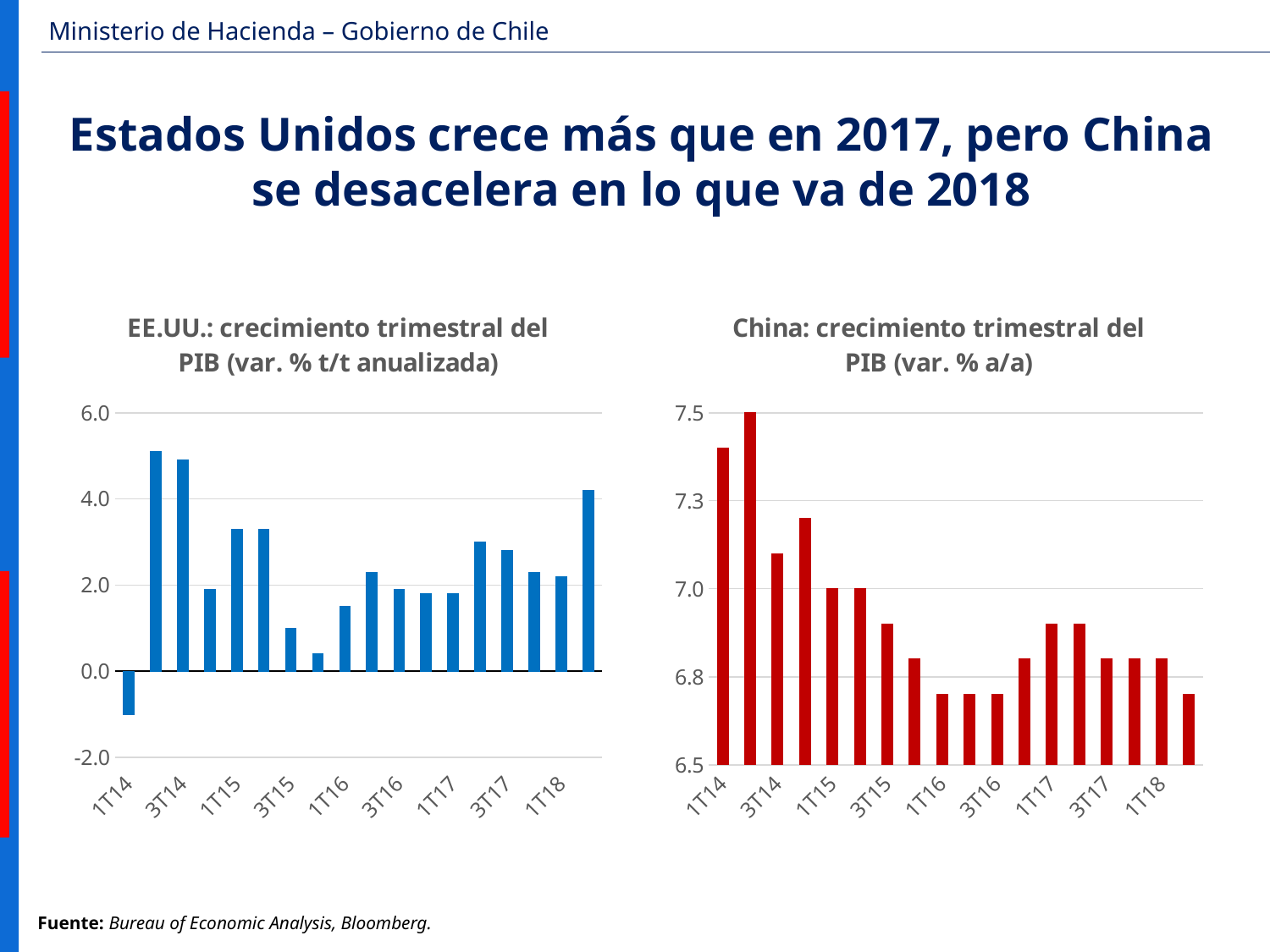
In the 'China: crecimiento trimestral del PIB' chart, is the value for 1T16 greater or less than 6.8? less What kind of chart is the 'EE.UU.: crecimiento trimestral del PIB' chart? bar chart In the 'EE.UU.: crecimiento trimestral del PIB' chart, which quarter has the lowest value? 1T14 In the 'China: crecimiento trimestral del PIB' chart, what is the value for 1T15? 7.0 In the 'China: crecimiento trimestral del PIB' chart, do the values generally rise or fall from 1T14 to 1T18? fall In the 'EE.UU.: crecimiento trimestral del PIB' chart, is the value for 3T14 greater or less than 4.0? greater In the 'EE.UU.: crecimiento trimestral del PIB' chart, is the value for 1T14 greater or less than 0.0? less In the 'EE.UU.: crecimiento trimestral del PIB' chart, which is larger, the value for 3T14 or the value for 1T15? 3T14 In the 'China: crecimiento trimestral del PIB' chart, which is larger, the value for 1T14 or the value for 1T18? 1T14 How many bars are plotted in the 'EE.UU.: crecimiento trimestral del PIB' chart? 18 What colour are the bars in the 'China: crecimiento trimestral del PIB' chart? red